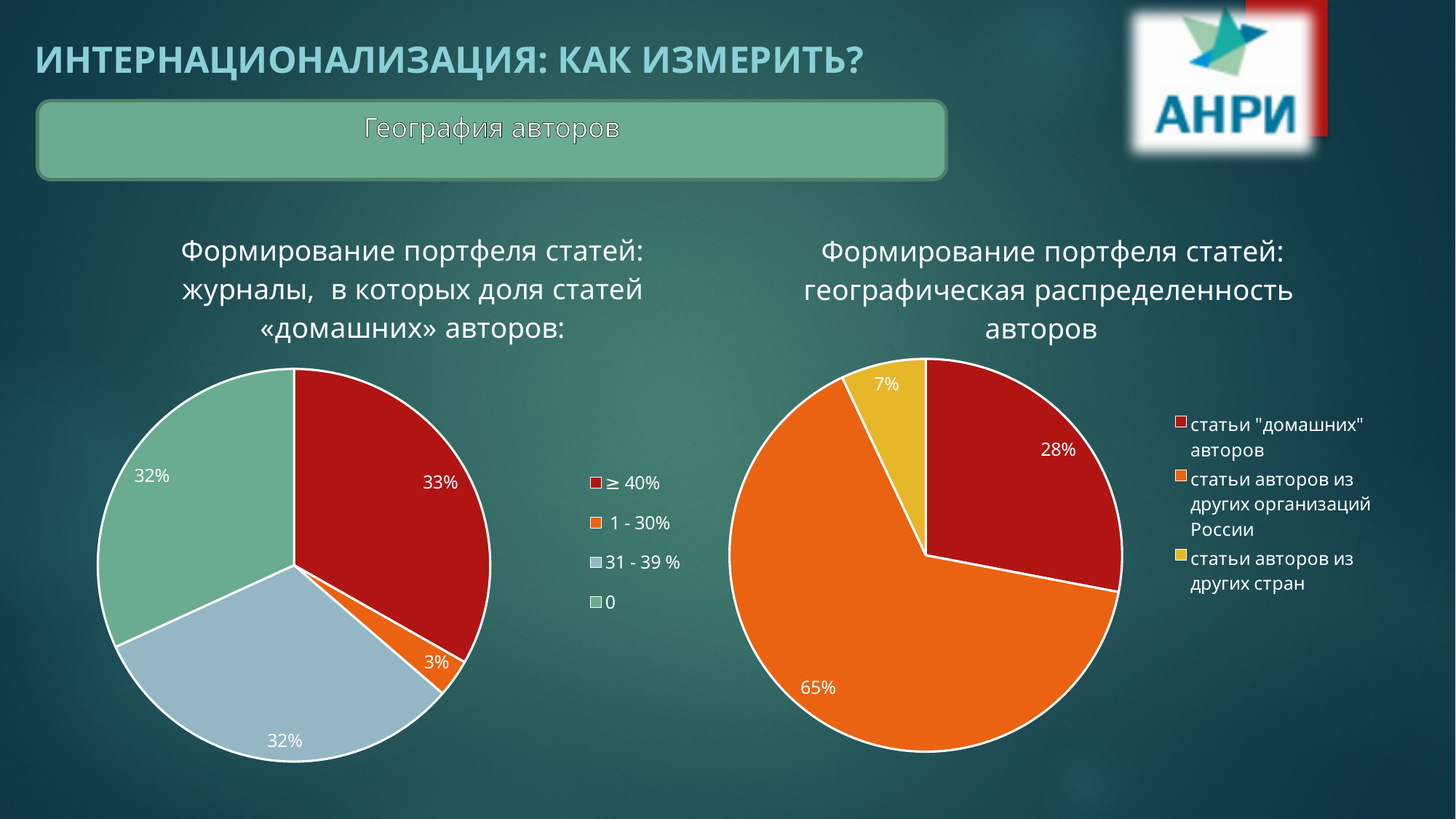
On the left chart, what share of journals have a share of 'home' authors' articles of ≥ 40%? 33% On the right chart, which category has the largest share? статьи авторов из других организаций России On the left chart, what is the difference between the '≥ 40%' slice and the '1 - 30%' slice? 30 percentage points On the right chart, what is the difference between the share of 'статьи "домашних" авторов' and 'статьи авторов из других стран'? 21 percentage points On the left chart, how many categories does the legend list? 4 On the right chart, what share is 'статьи авторов из других организаций России'? 65% On the left chart, what share corresponds to the category '31 - 39 %'? 32% On the right chart, what share is 'статьи авторов из других стран'? 7% On the left chart, which category has the smallest slice? 1 - 30% On the left chart, which category has the largest slice? ≥ 40% What type of chart is used on the right side of the slide? Pie chart On the left chart, what share corresponds to the category '1 - 30%'? 3%